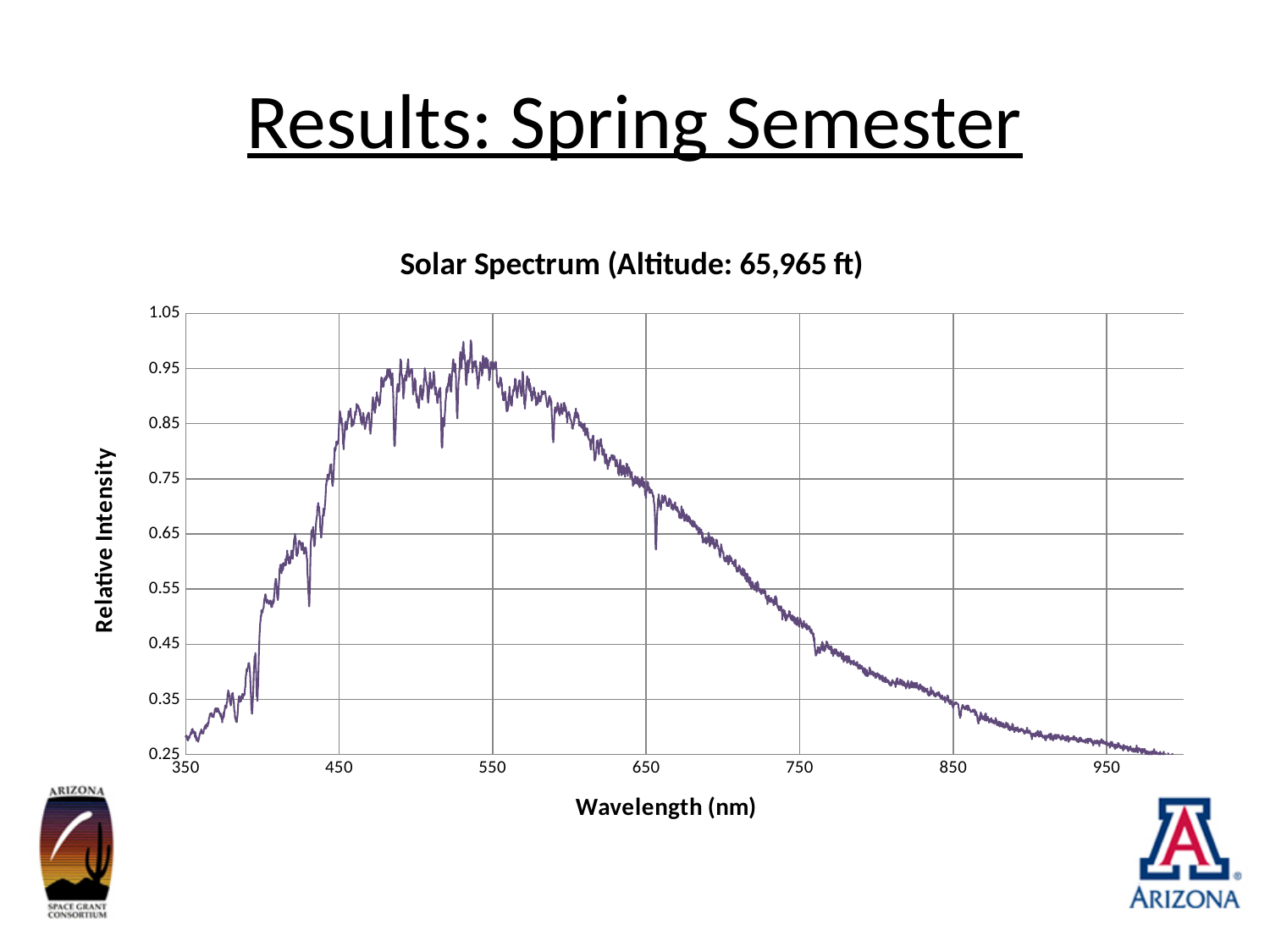
Does the relative intensity rise or fall as wavelength increases from 650 nm to 950 nm? fall Is the relative intensity at 950 nm greater or less than 0.35? less What is the label of the vertical axis of the chart? Relative Intensity Is the relative intensity at 450 nm greater or less than 0.75? greater Which wavelength has the higher relative intensity, 450 nm or 850 nm? 450 nm Is the relative intensity at 750 nm greater or less than 0.55? less What kind of chart is shown on the slide? line chart What is the title of the chart? Solar Spectrum (Altitude: 65,965 ft) Does the relative intensity rise or fall as wavelength increases from 350 nm to 450 nm? rise